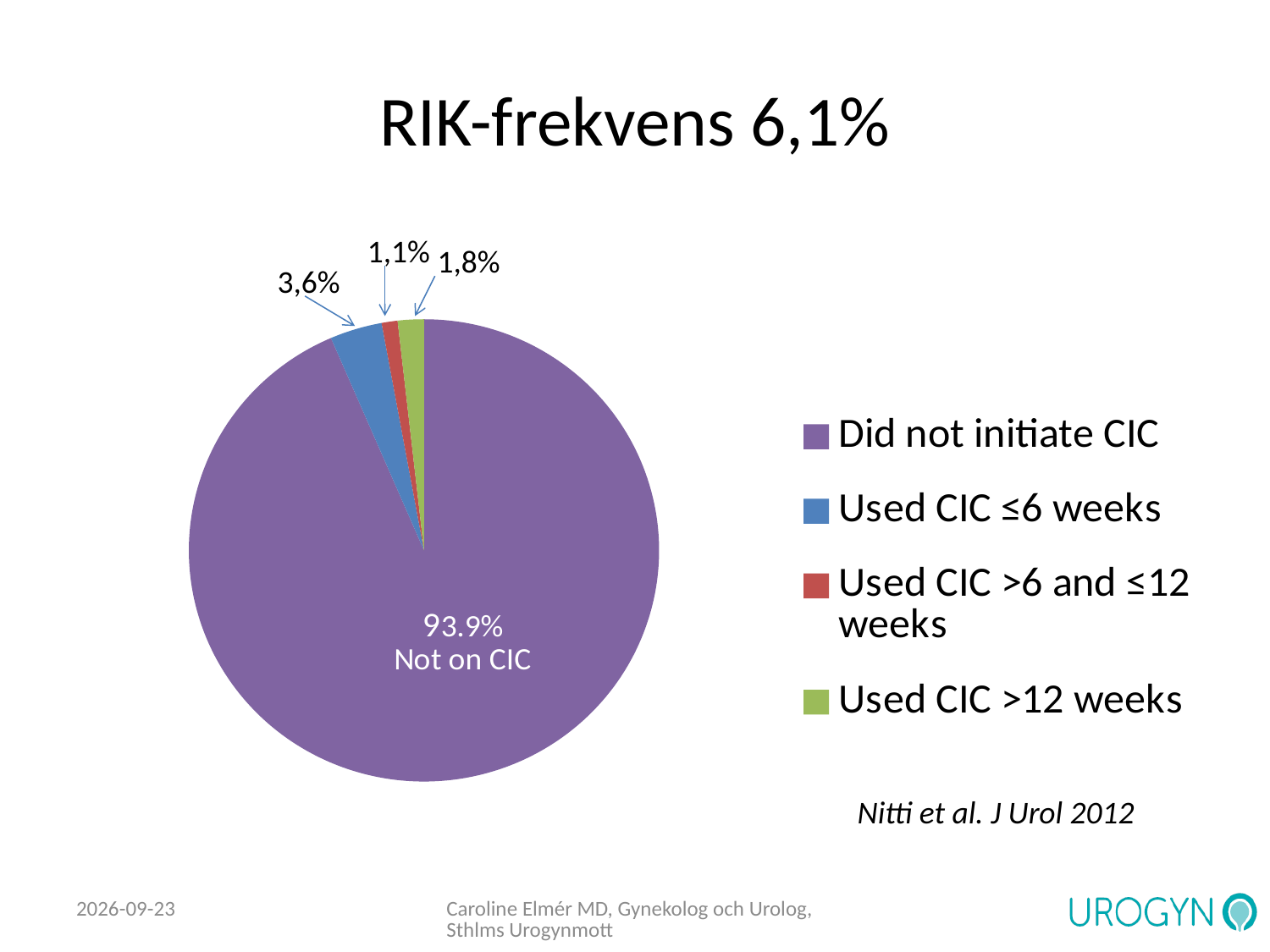
How many entries does the legend list? 4 Which category has the smallest slice of the pie? Used CIC >6 and ≤12 weeks How many slices does the pie chart have? 4 What share of the pie is labelled for "Used CIC ≤6 weeks"? 3,6% What percentage is printed inside the large purple slice? 93.9% What colour is the slice for "Used CIC >12 weeks"? green What share of the pie is labelled for "Used CIC >12 weeks"? 1,8% Which category has the largest slice of the pie? Did not initiate CIC What kind of chart is shown on the slide? pie chart What is the title of the slide containing the pie chart? RIK-frekvens 6,1% Which slice is larger: "Used CIC ≤6 weeks" or "Used CIC >12 weeks"? Used CIC ≤6 weeks What share of the pie is labelled for "Used CIC >6 and ≤12 weeks"? 1,1%